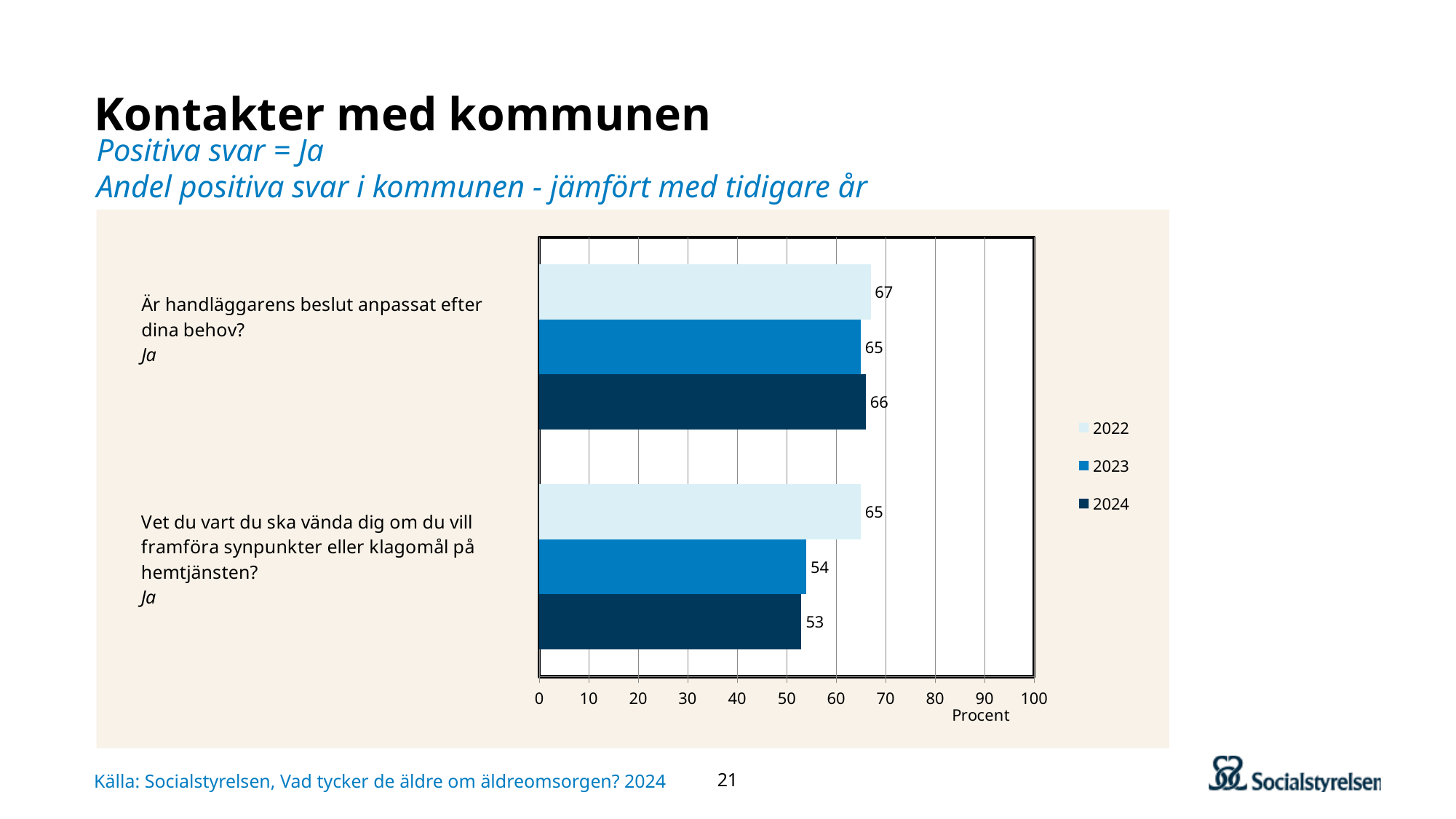
Which year has the highest value for "Är handläggarens beslut anpassat efter dina behov?"? 2022 What is the 2022 value for "Är handläggarens beslut anpassat efter dina behov?"? 67 How many questions (categories) are shown in the chart? 2 Which is larger for 2024: the value for "Är handläggarens beslut anpassat efter dina behov?" or for "Vet du vart du ska vända dig om du vill framföra synpunkter eller klagomål på hemtjänsten?"? Är handläggarens beslut anpassat efter dina behov? What is the 2022 value for "Vet du vart du ska vända dig om du vill framföra synpunkter eller klagomål på hemtjänsten?"? 65 What is the label of the horizontal axis? Procent What is the 2024 value for "Är handläggarens beslut anpassat efter dina behov?"? 66 Which year has the lowest value for "Vet du vart du ska vända dig om du vill framföra synpunkter eller klagomål på hemtjänsten?"? 2024 What is the 2023 value for "Vet du vart du ska vända dig om du vill framföra synpunkter eller klagomål på hemtjänsten?"? 54 What kind of chart is shown on the slide? Bar chart What is the difference between the 2022 and 2024 values for "Vet du vart du ska vända dig om du vill framföra synpunkter eller klagomål på hemtjänsten?"? 12 How many years does the legend list? 3